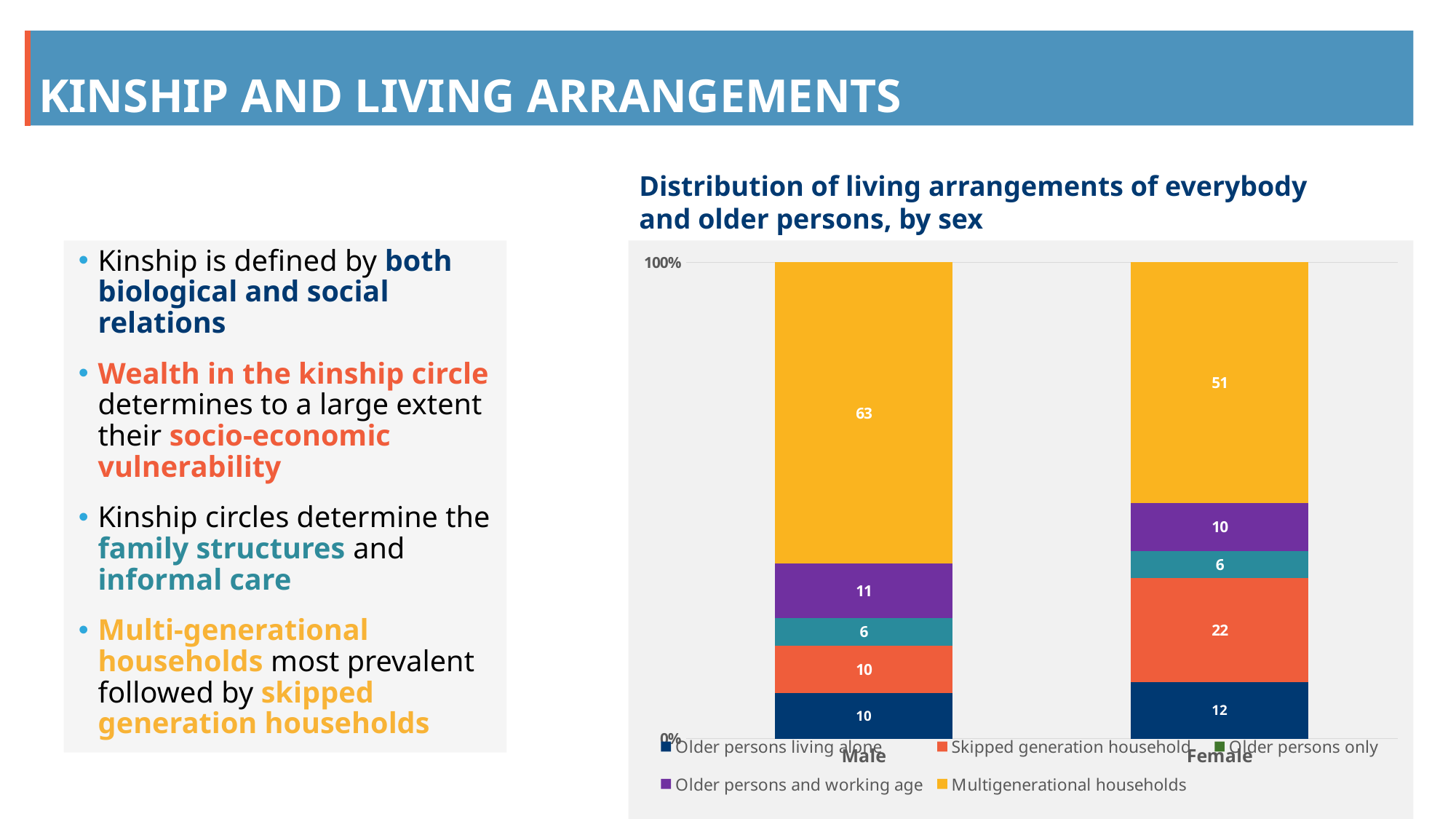
How many series does the legend list? 5 What is the smallest value labelled in the Female bar? 6 How many categories are shown on the x axis? 2 What is the value for Multigenerational households in the Male bar? 63 How much larger is the Multigenerational households value for Male than for Female? 12 What is the difference between the Skipped generation household values for Female and Male? 12 Which living arrangement has the largest value in the Female bar? Multigenerational households What is the value for Skipped generation household in the Female bar? 22 What is the value for Older persons and working age in the Female bar? 10 What is the value for Older persons living alone in the Male bar? 10 Which has the larger value for Older persons living alone, Male or Female? Female What kind of chart is shown on the slide? Stacked bar chart